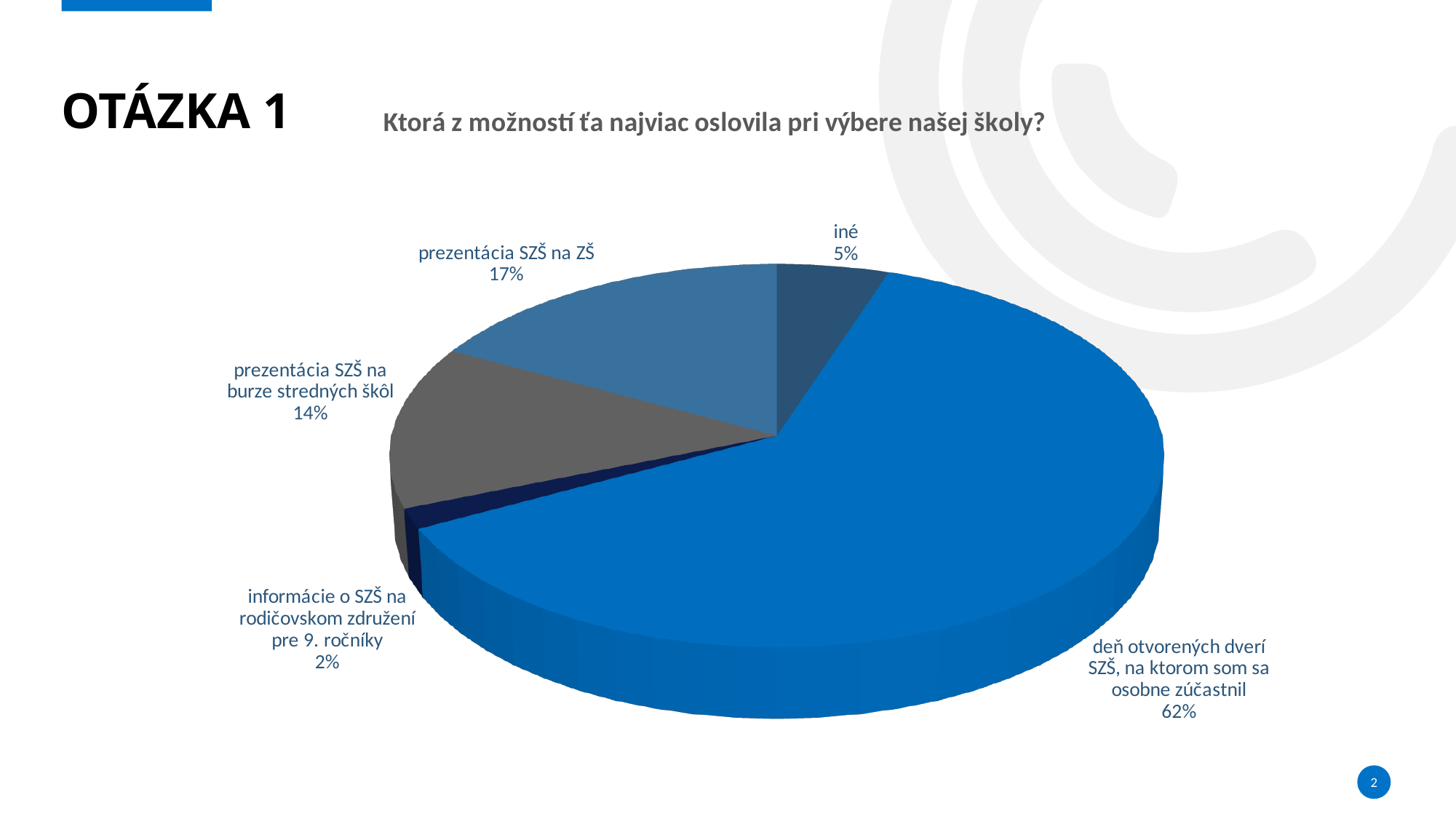
What share of the pie does "iné" have? 5% What share of the pie does "prezentácia SZŠ na burze stredných škôl" have? 14% What is the title of the chart? Ktorá z možností ťa najviac oslovila pri výbere našej školy? What share of the pie does "deň otvorených dverí SZŠ, na ktorom som sa osobne zúčastnil" have? 62% What kind of chart is shown on the slide? pie chart What is the difference in percentage points between "prezentácia SZŠ na ZŠ" and "prezentácia SZŠ na burze stredných škôl"? 3 percentage points Which category has the largest slice of the pie? deň otvorených dverí SZŠ, na ktorom som sa osobne zúčastnil Which category has the smallest slice of the pie? informácie o SZŠ na rodičovskom združení pre 9. ročníky Which is larger: the share for "iné" or the share for "informácie o SZŠ na rodičovskom združení pre 9. ročníky"? iné How many categories are shown in the pie chart? 5